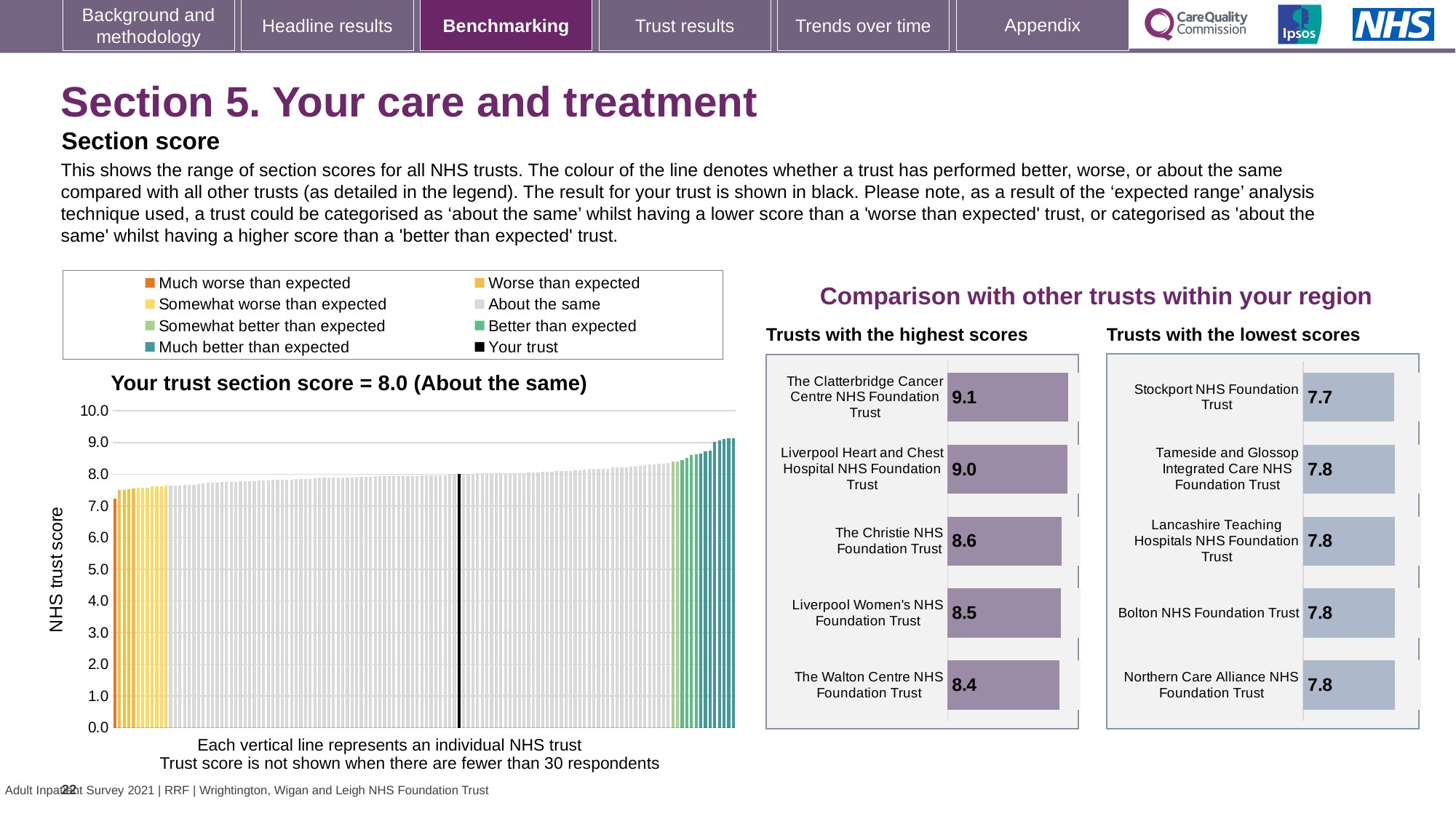
In the 'Your trust section score' chart, is the value of the leftmost (orange) bar greater or less than 8.0? less In the 'Your trust section score' chart, do the trust scores rise or fall from left to right along the x axis? rise In the 'Trusts with the lowest scores' chart, what is the score for Bolton NHS Foundation Trust? 7.8 In the 'Trusts with the lowest scores' chart, what is the difference between the scores of Northern Care Alliance NHS Foundation Trust and Stockport NHS Foundation Trust? 0.1 How many entries does the legend above the 'Your trust section score' chart list? 8 In the 'Your trust section score' chart, what is the section score for your trust? 8.0 In the 'Trusts with the highest scores' chart, what is the difference between the scores of The Clatterbridge Cancer Centre NHS Foundation Trust and The Walton Centre NHS Foundation Trust? 0.7 How many trusts are listed in the 'Trusts with the highest scores' chart? 5 In the 'Trusts with the lowest scores' chart, which trust has the lowest score? Stockport NHS Foundation Trust In the 'Trusts with the highest scores' chart, which trust has the lowest score shown? The Walton Centre NHS Foundation Trust In the 'Trusts with the highest scores' chart, which has the higher score: The Christie NHS Foundation Trust or Liverpool Women's NHS Foundation Trust? The Christie NHS Foundation Trust In the 'Trusts with the highest scores' chart, what is the score for The Clatterbridge Cancer Centre NHS Foundation Trust? 9.1